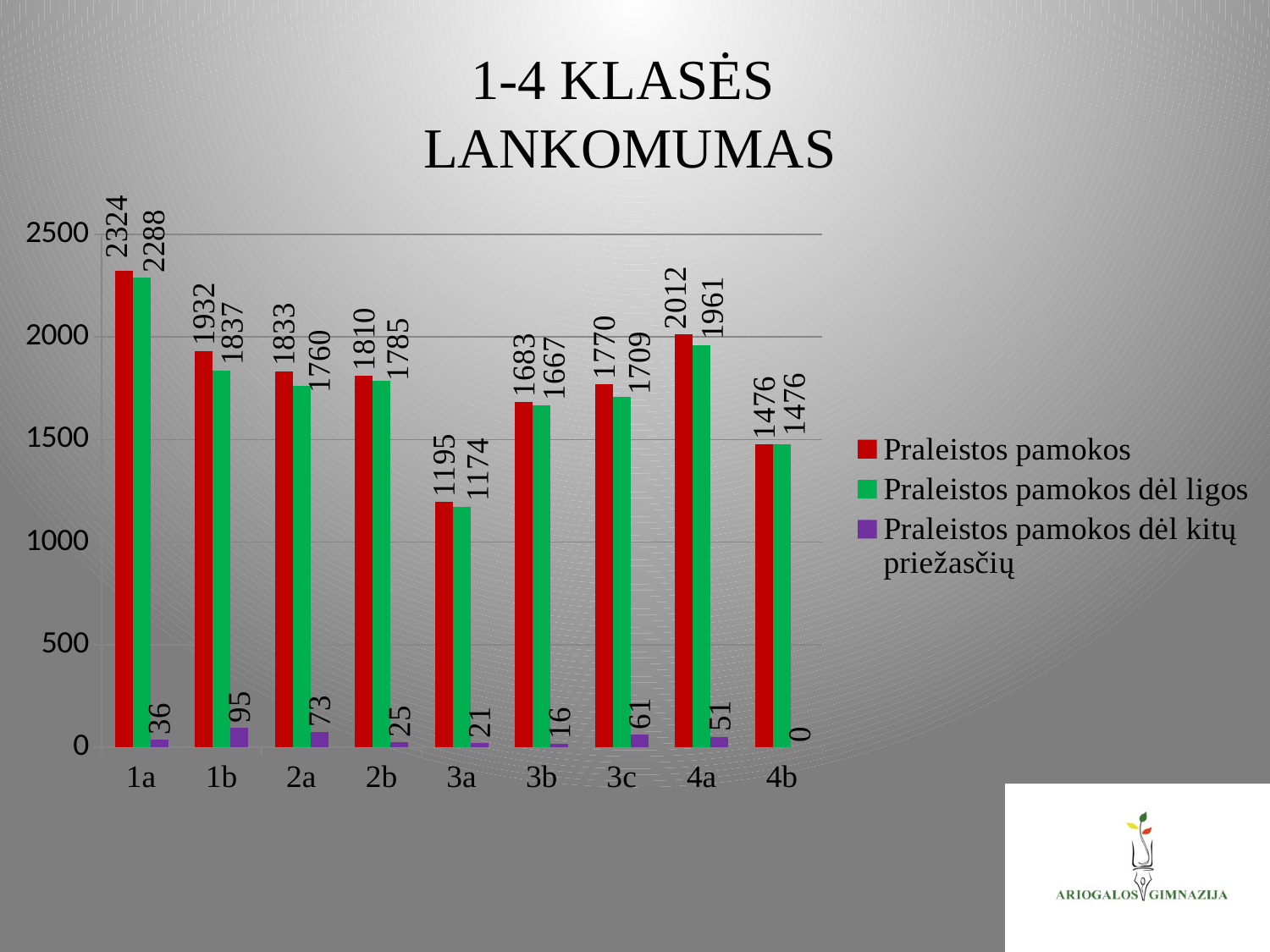
What is the value of Praleistos pamokos dėl kitų priežasčių for class 1b? 95 What is the difference between Praleistos pamokos and Praleistos pamokos dėl ligos for class 1b? 95 Which class has the lowest value for Praleistos pamokos dėl ligos? 3a How many classes are shown on the x axis? 9 How many series does the legend list? 3 What is the title of the slide? 1-4 KLASĖS LANKOMUMAS What is the value of Praleistos pamokos for class 1a? 2324 Which class has the lowest value for Praleistos pamokos dėl kitų priežasčių? 4b Which is larger: Praleistos pamokos for class 4a or for class 3c? 4a What is the value of Praleistos pamokos dėl ligos for class 2b? 1785 What kind of chart is shown on the slide? bar chart Which class has the highest value for Praleistos pamokos? 1a